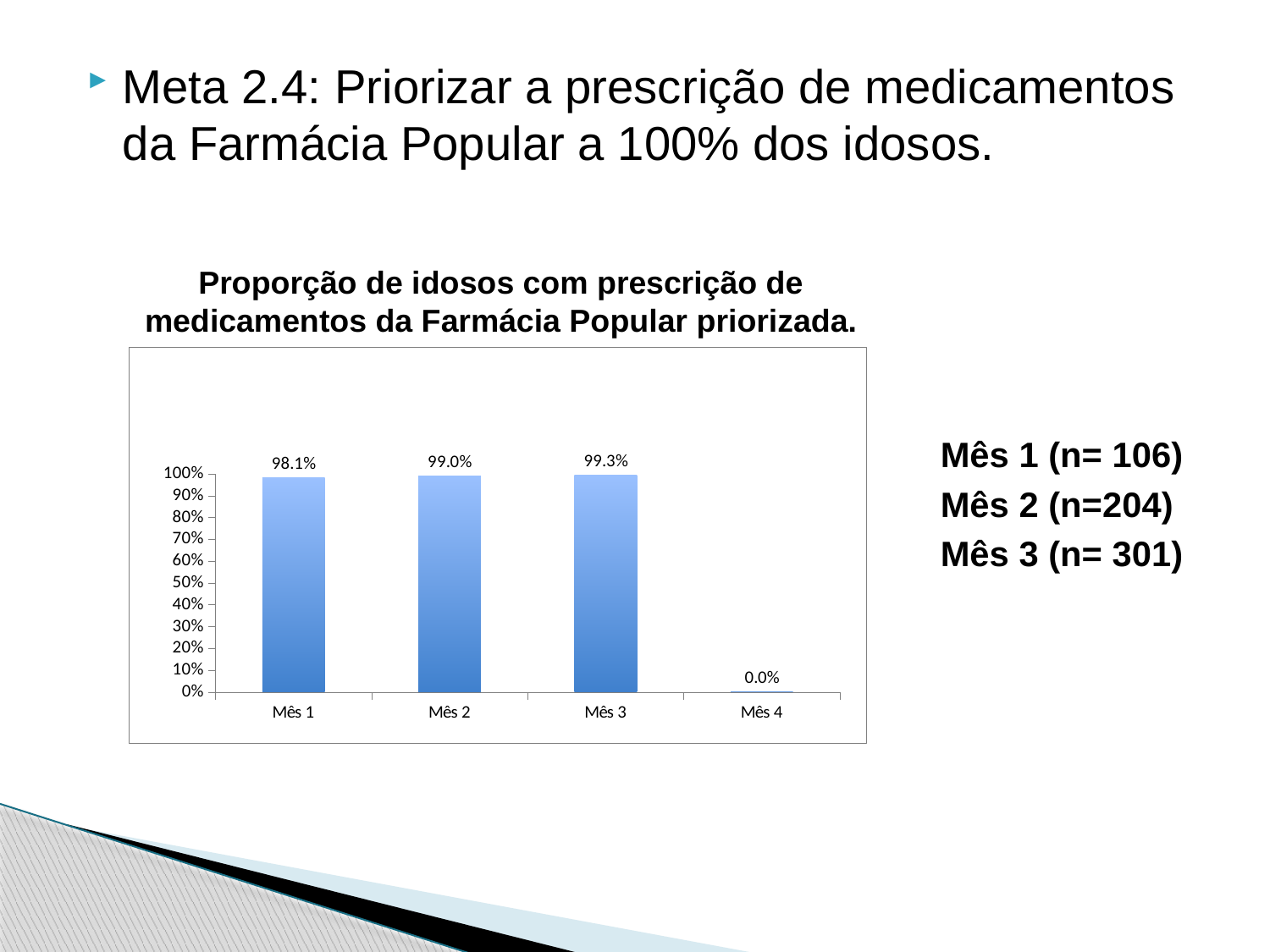
How many months are shown on the x axis? 4 Which month has the highest value? Mês 3 Is the value for Mês 2 greater or less than 90%? greater What is the title of the chart? Proporção de idosos com prescrição de medicamentos da Farmácia Popular priorizada. Which is larger, the value for Mês 1 or the value for Mês 2? Mês 2 What kind of chart is shown on the slide? bar chart What is the value for Mês 3? 99.3% What is the value for Mês 4? 0.0% What is the difference between the values for Mês 3 and Mês 1? 1.2% What is the value for Mês 1? 98.1% Which month has the lowest value? Mês 4 What is the value for Mês 2? 99.0%